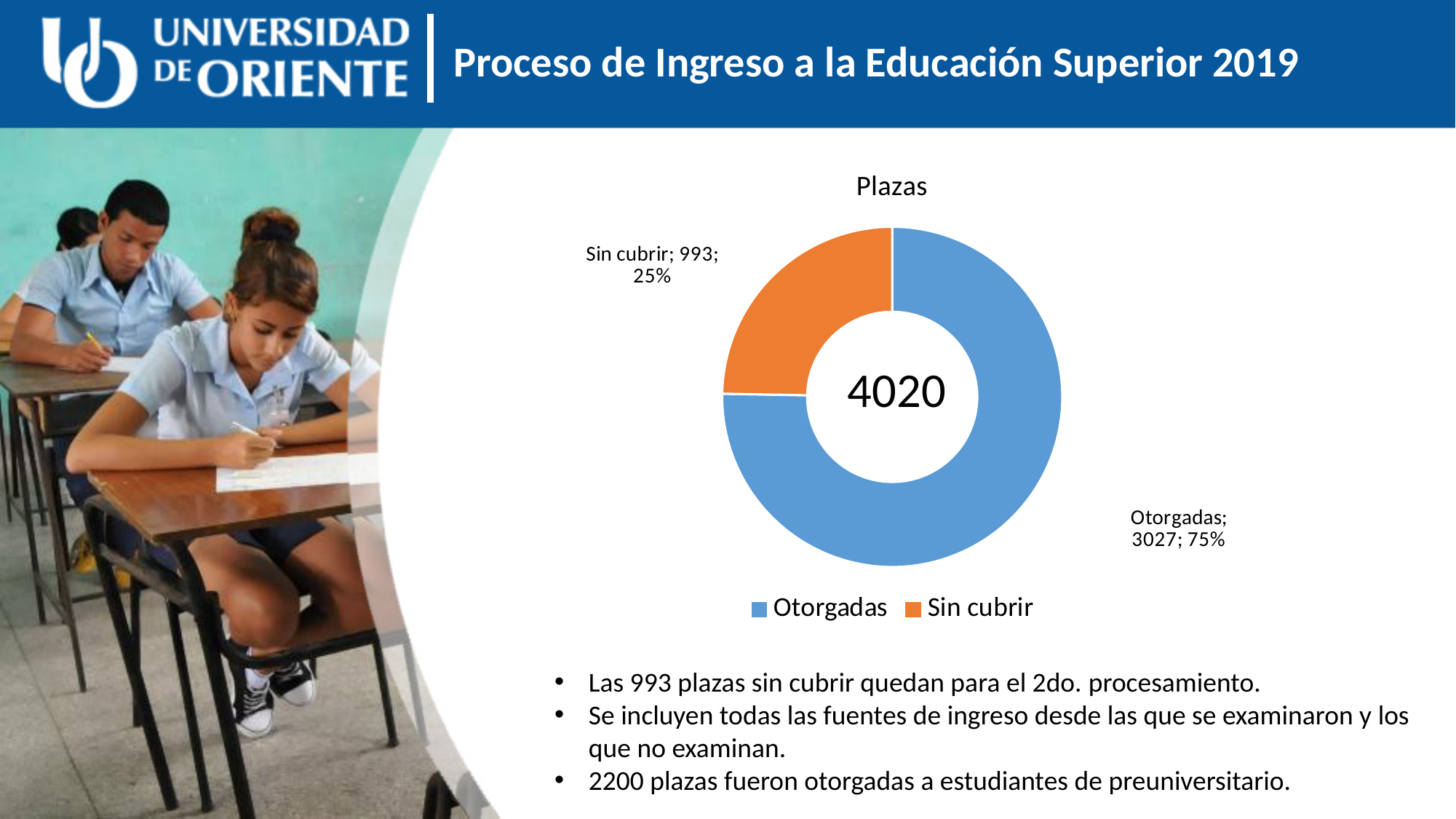
What share of the Plazas chart does Sin cubrir represent? 25% What colour is the Sin cubrir slice in the Plazas chart? Orange What kind of chart is the Plazas chart? Doughnut (pie) chart How many categories are shown in the Plazas chart? 2 What is the value for Otorgadas in the Plazas chart? 3027 Which is larger in the Plazas chart, Otorgadas or Sin cubrir? Otorgadas Which category has the largest slice in the Plazas chart? Otorgadas What is the total of all slices in the Plazas chart? 4020 What share of the Plazas chart does Otorgadas represent? 75% What is the difference between Otorgadas and Sin cubrir in the Plazas chart? 2034 What is the value for Sin cubrir in the Plazas chart? 993 Which category has the smallest slice in the Plazas chart? Sin cubrir